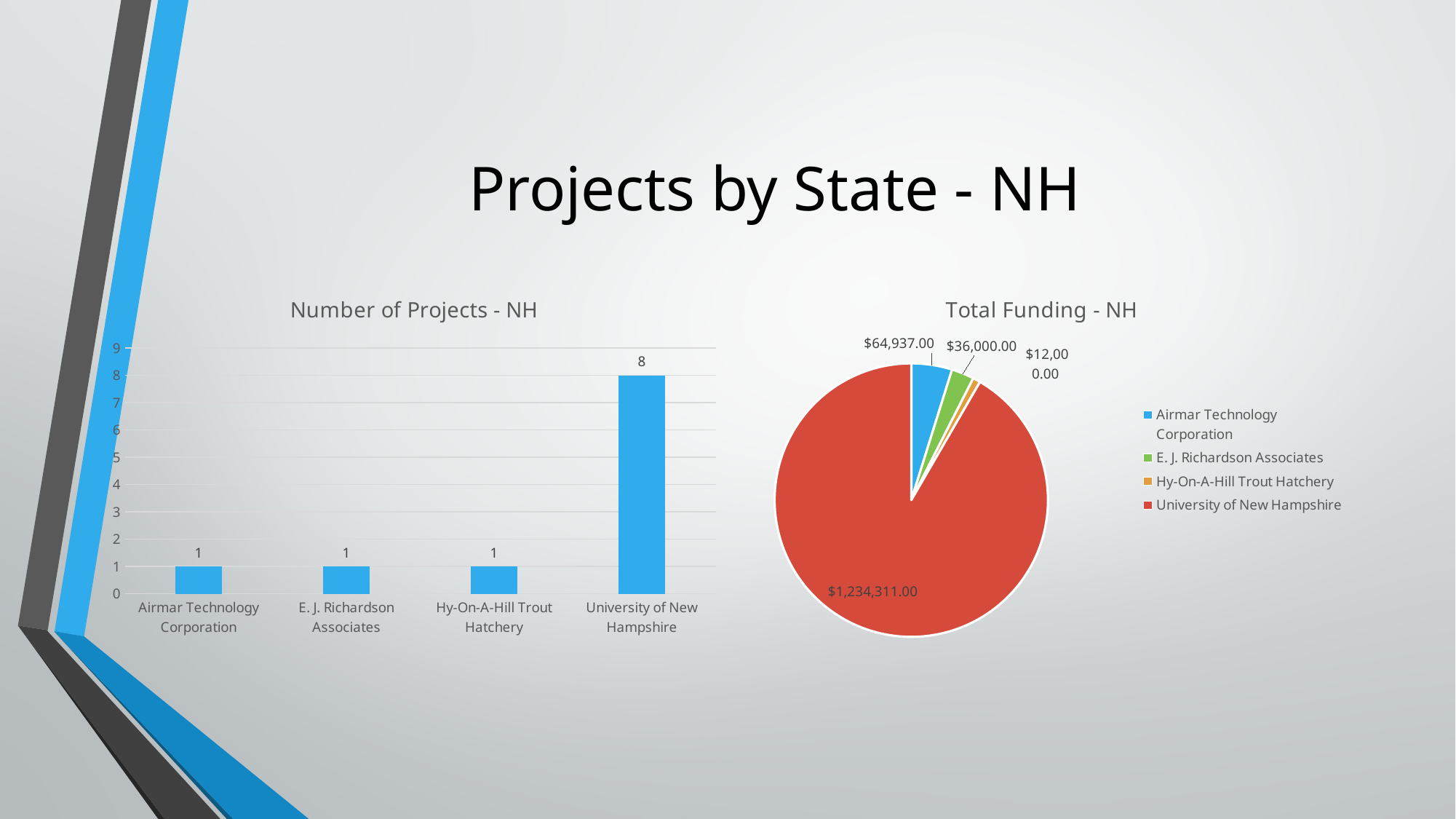
In the 'Total Funding - NH' chart, what is the total funding for the University of New Hampshire? $1,234,311.00 In the 'Total Funding - NH' chart, which organization has the smallest slice? Hy-On-A-Hill Trout Hatchery In the 'Number of Projects - NH' chart, what is the difference between the number of projects for the University of New Hampshire and for Hy-On-A-Hill Trout Hatchery? 7 In the 'Number of Projects - NH' chart, how many projects does the University of New Hampshire have? 8 In the 'Total Funding - NH' chart, what is the total funding for E. J. Richardson Associates? $36,000.00 In the 'Number of Projects - NH' chart, how many categories are shown on the x axis? 4 In the 'Total Funding - NH' chart, what is the total funding for Airmar Technology Corporation? $64,937.00 In the 'Total Funding - NH' chart, how many entries does the legend list? 4 What kind of chart is 'Number of Projects - NH'? Bar chart In the 'Total Funding - NH' chart, which is larger: the funding for Airmar Technology Corporation or for E. J. Richardson Associates? Airmar Technology Corporation In the 'Number of Projects - NH' chart, which category has the highest number of projects? University of New Hampshire In the 'Number of Projects - NH' chart, how many projects does Airmar Technology Corporation have? 1